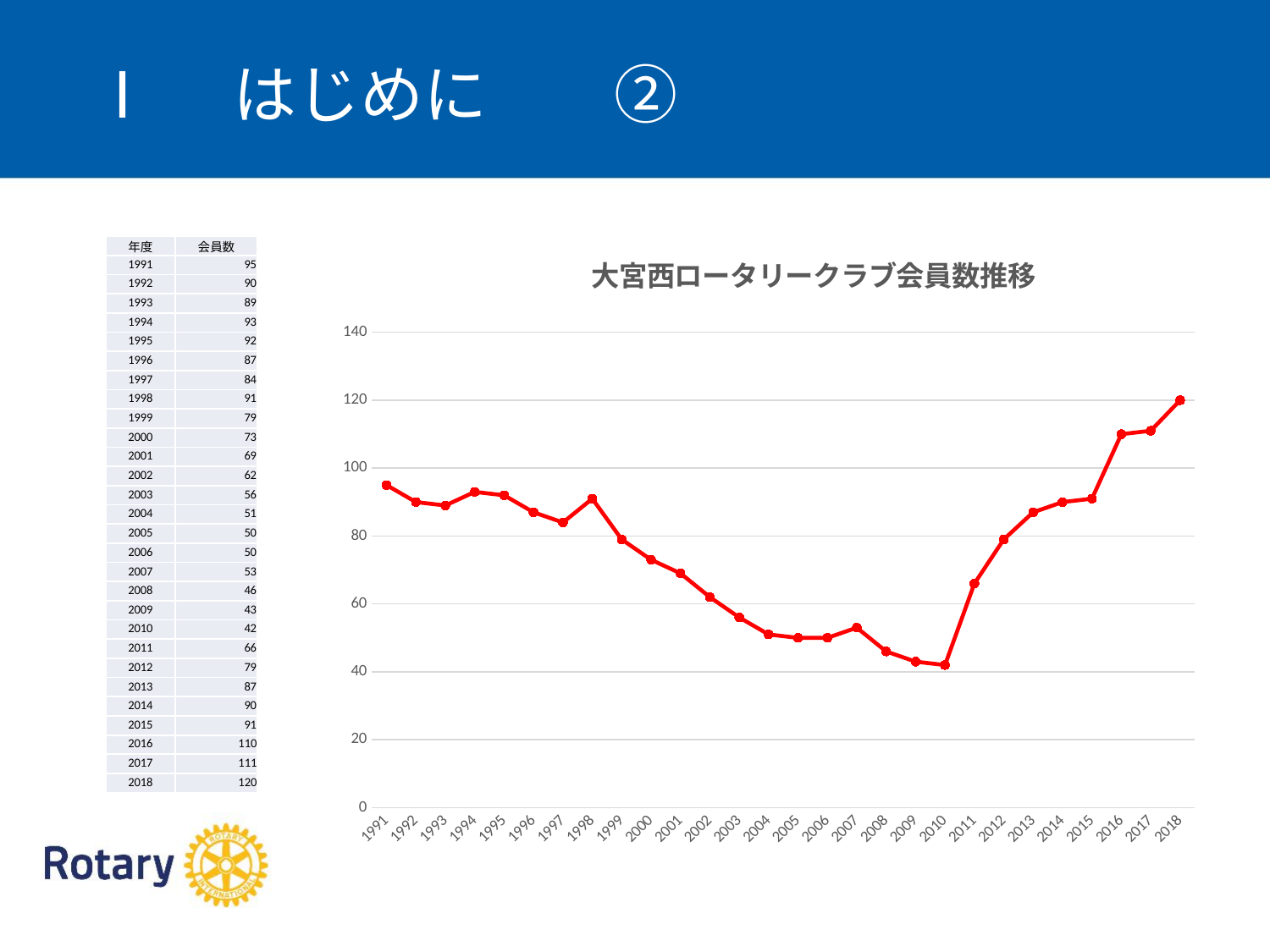
How many years are plotted on the x axis of the chart? 28 Which year has the highest membership value? 2018 Is the membership value for 2016 greater or less than 100? greater Do the membership values rise or fall from 2010 to 2018? rise What is the membership value for 1991? 95 Which is larger, the membership value for 1998 or for 2012? 1998 What type of chart is shown on the slide? line chart What is the membership value for 2010? 42 What is the membership value for 2018? 120 Which year has the lowest membership value? 2010 What is the title of the chart? 大宮西ロータリークラブ会員数推移 What is the difference between the membership values for 2018 and 2010? 78